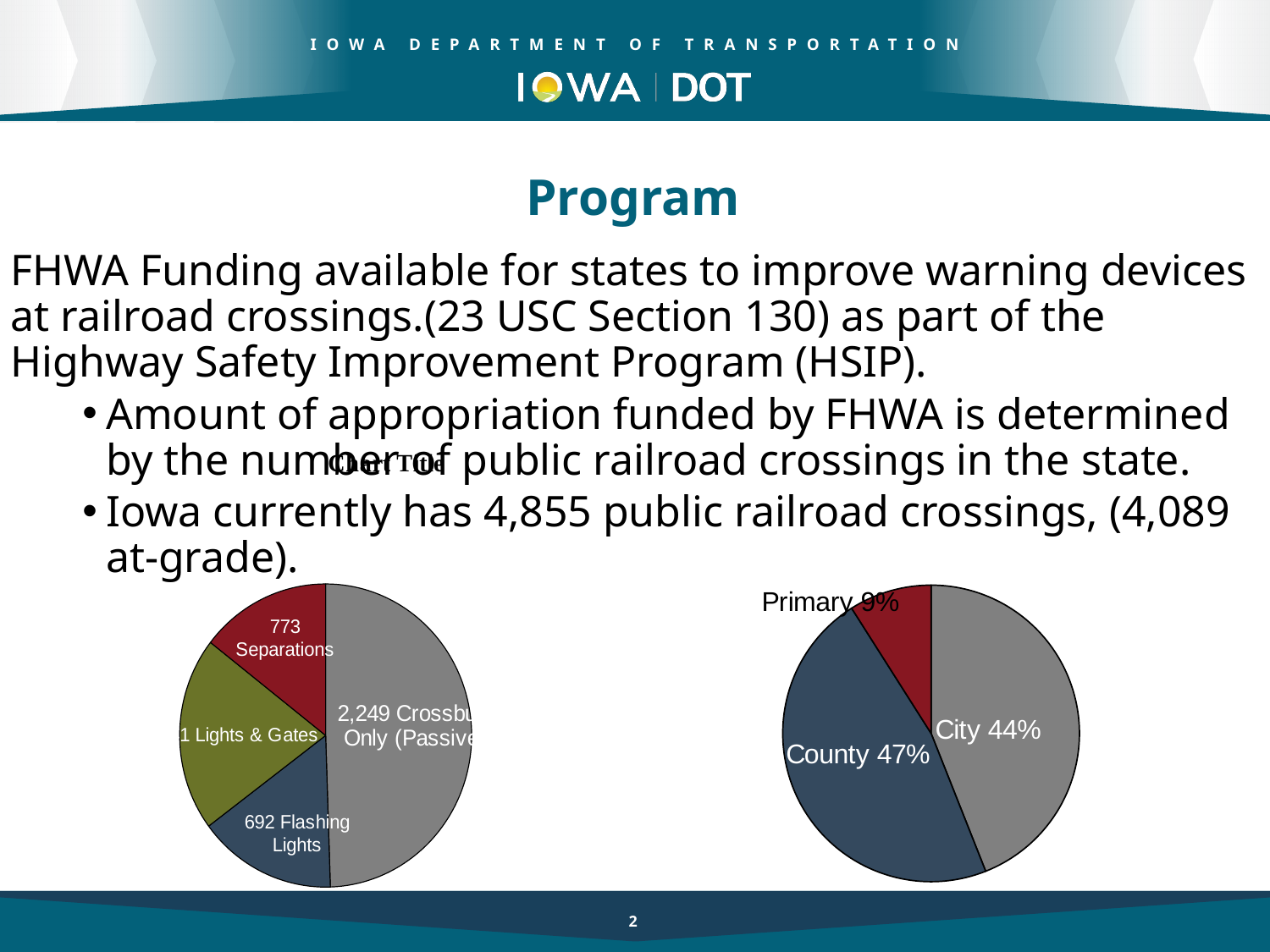
On the left pie chart, how many crossings are labelled as Flashing Lights? 692 On the right pie chart, which category has the largest share? County On the right pie chart, what percentage is shown for Primary? 9% How many slices does the right pie chart have? 3 On the right pie chart, what percentage is shown for City? 44% On the left pie chart, how many crossings are labelled as Separations? 773 On the right pie chart, how many percentage points larger is County than City? 3% On the right pie chart, what percentage is shown for County? 47% On the right pie chart, which category has the smallest share? Primary What type of chart is used on the left side of the slide? Pie chart On the left pie chart, which category has the largest slice? Crossbucks Only (Passive) On the left pie chart, what is the difference between the Separations value and the Flashing Lights value? 81